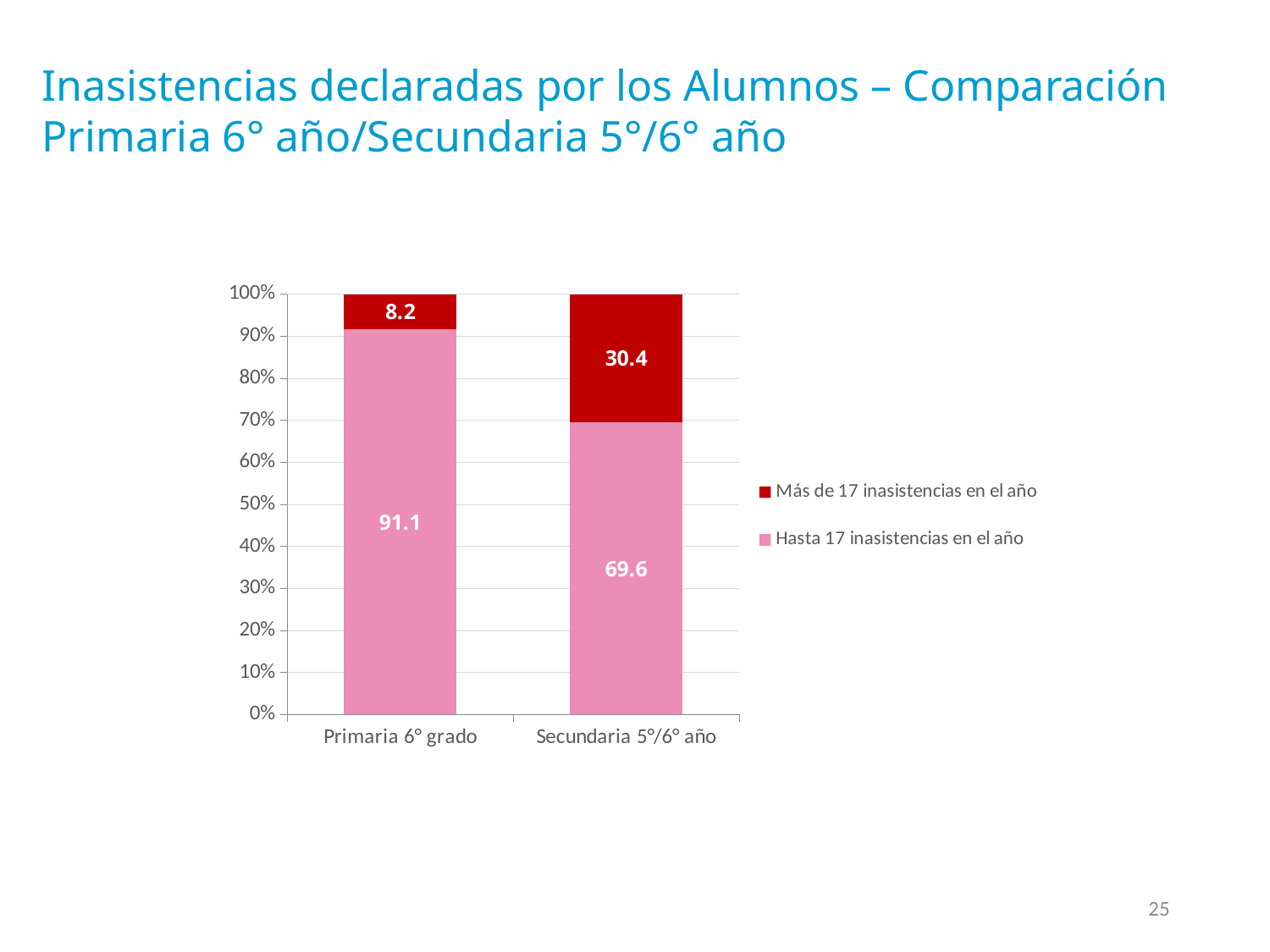
What is the value for 'Más de 17 inasistencias en el año' for Secundaria 5°/6° año? 30.4 What kind of chart is shown on the slide? stacked bar chart What is the value for 'Más de 17 inasistencias en el año' for Primaria 6° grado? 8.2 How many series does the legend list? 2 What is the value for 'Hasta 17 inasistencias en el año' for Secundaria 5°/6° año? 69.6 Which category has the lower value for 'Hasta 17 inasistencias en el año'? Secundaria 5°/6° año How many categories are shown on the x axis? 2 What is the difference between the 'Más de 17 inasistencias en el año' values for Secundaria 5°/6° año and Primaria 6° grado? 22.2 Is the 'Más de 17 inasistencias en el año' value for Primaria 6° grado larger or smaller than that for Secundaria 5°/6° año? smaller Which category has the higher value for 'Más de 17 inasistencias en el año'? Secundaria 5°/6° año What is the value for 'Hasta 17 inasistencias en el año' for Primaria 6° grado? 91.1 What is the difference between the 'Hasta 17 inasistencias en el año' values for Primaria 6° grado and Secundaria 5°/6° año? 21.5